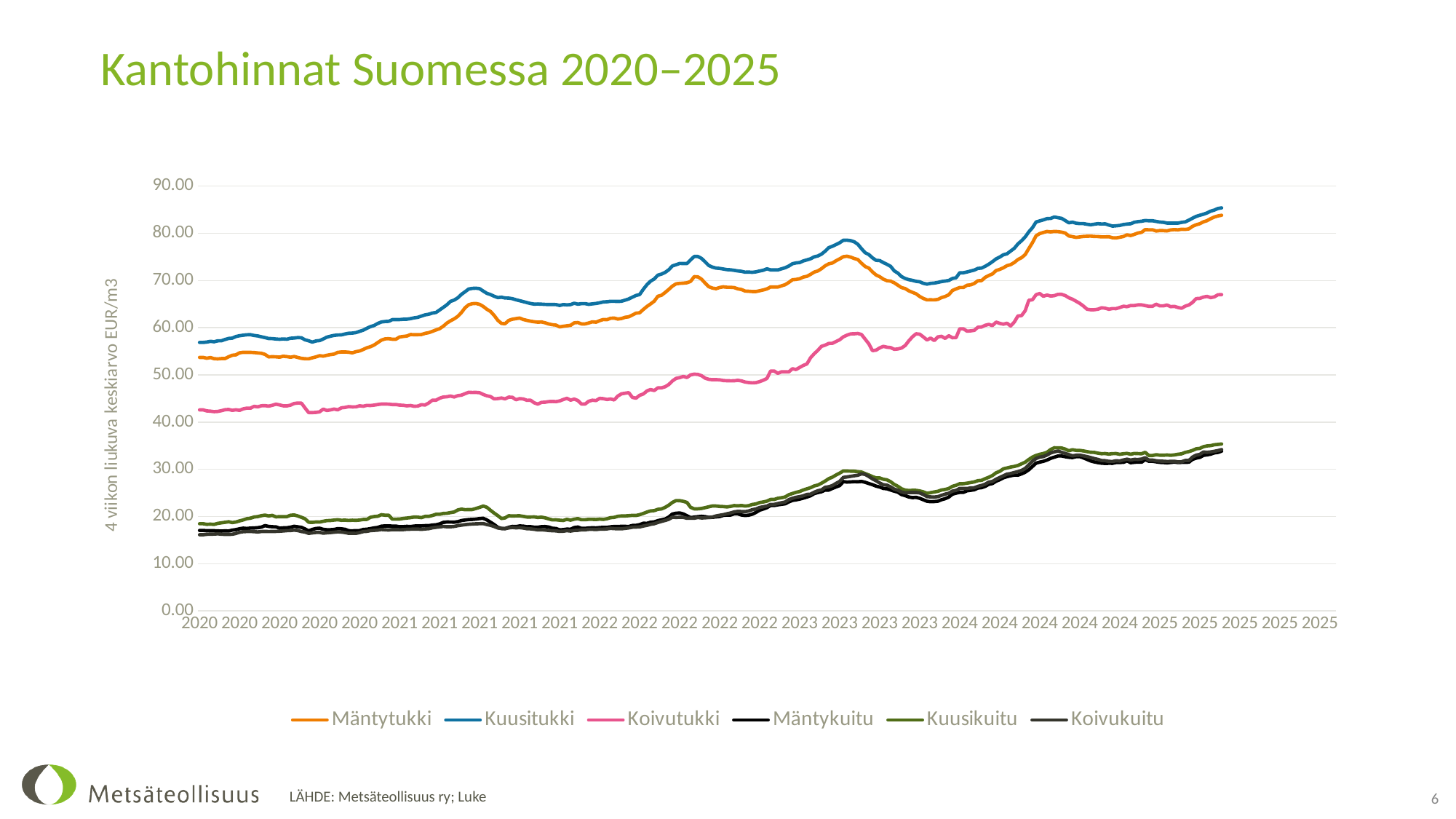
How many series does the legend list? 6 What is the label on the vertical axis? 4 viikon liukuva keskiarvo EUR/m3 Do the values for Koivutukki rise or fall overall from 2020 to 2025? rise Is the value for Kuusikuitu at the end of the series in 2025 greater or less than 30.00? greater Is the value for Kuusitukki at the end of the series in 2025 greater or less than 80.00? greater What is the title of the chart? Kantohinnat Suomessa 2020–2025 Which series has the highest values across the whole chart? Kuusitukki Is the value for Mäntytukki at the start of 2020 greater or less than 50.00? greater What type of chart is shown on the slide? line chart Do the values for Kuusitukki rise or fall overall from 2020 to 2025? rise Which is larger at the end of the series in 2025, Kuusitukki or Koivutukki? Kuusitukki